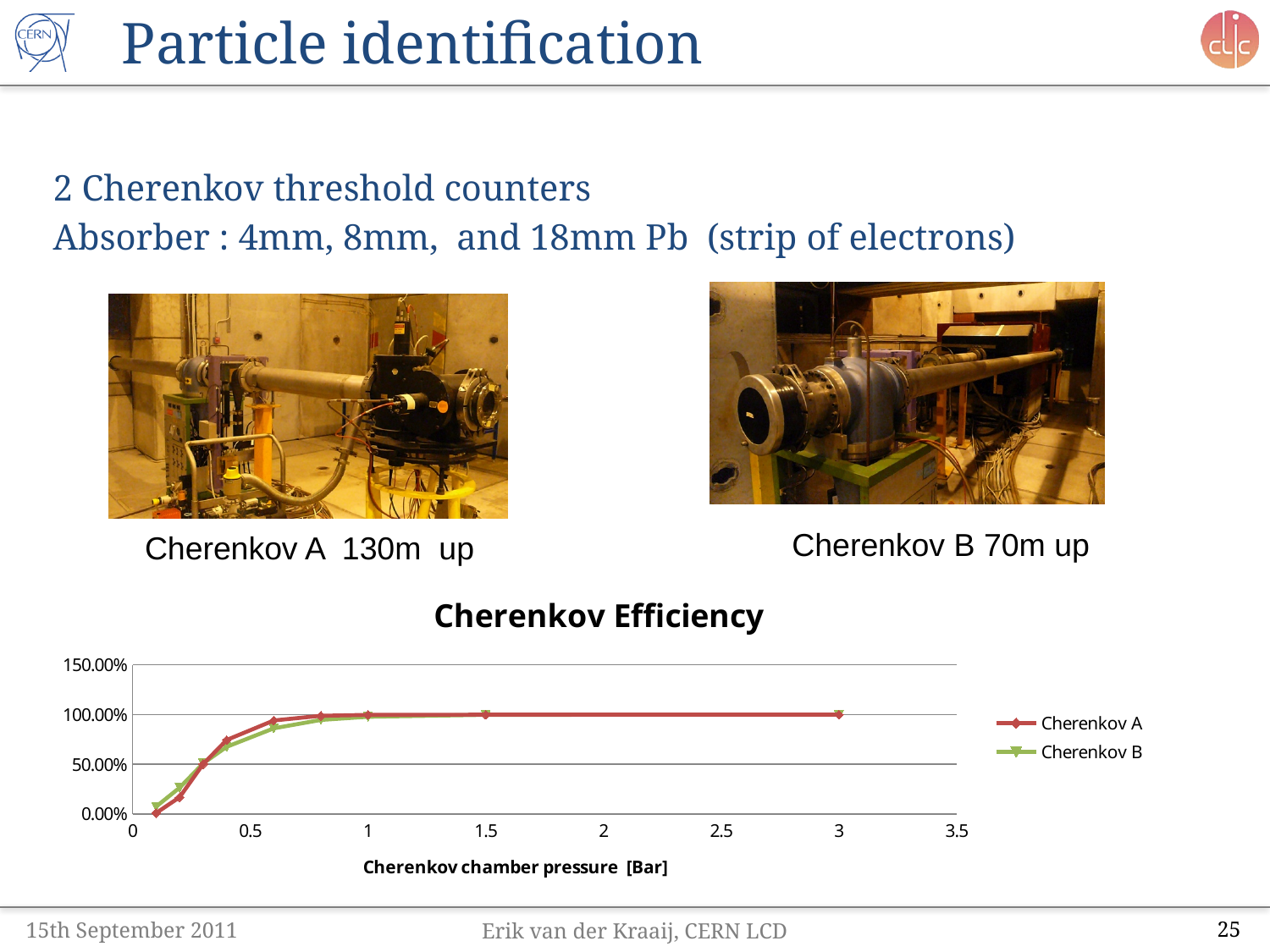
In the Cherenkov Efficiency chart, what is the highest value shown on the y axis? 150.00% In the Cherenkov Efficiency chart, which series has the higher value at 0.4 Bar, Cherenkov A or Cherenkov B? Cherenkov A In the Cherenkov Efficiency chart, is the value for Cherenkov A at 0.2 Bar greater or less than 50.00%? less How many series does the legend of the Cherenkov Efficiency chart list? 2 What kind of chart is the Cherenkov Efficiency chart? line chart In the Cherenkov Efficiency chart, is the value for Cherenkov B at 0.1 Bar greater or less than 50.00%? less In the Cherenkov Efficiency chart, is the value for Cherenkov B at 3 Bar greater or less than 150.00%? less In the Cherenkov Efficiency chart, which series has the higher value at 0.2 Bar, Cherenkov A or Cherenkov B? Cherenkov B In the Cherenkov Efficiency chart, do the efficiency values rise or fall as the chamber pressure increases from 0 to 1 Bar? rise What is the x-axis label of the Cherenkov Efficiency chart? Cherenkov chamber pressure [Bar] What is the title of the chart at the bottom of the slide? Cherenkov Efficiency